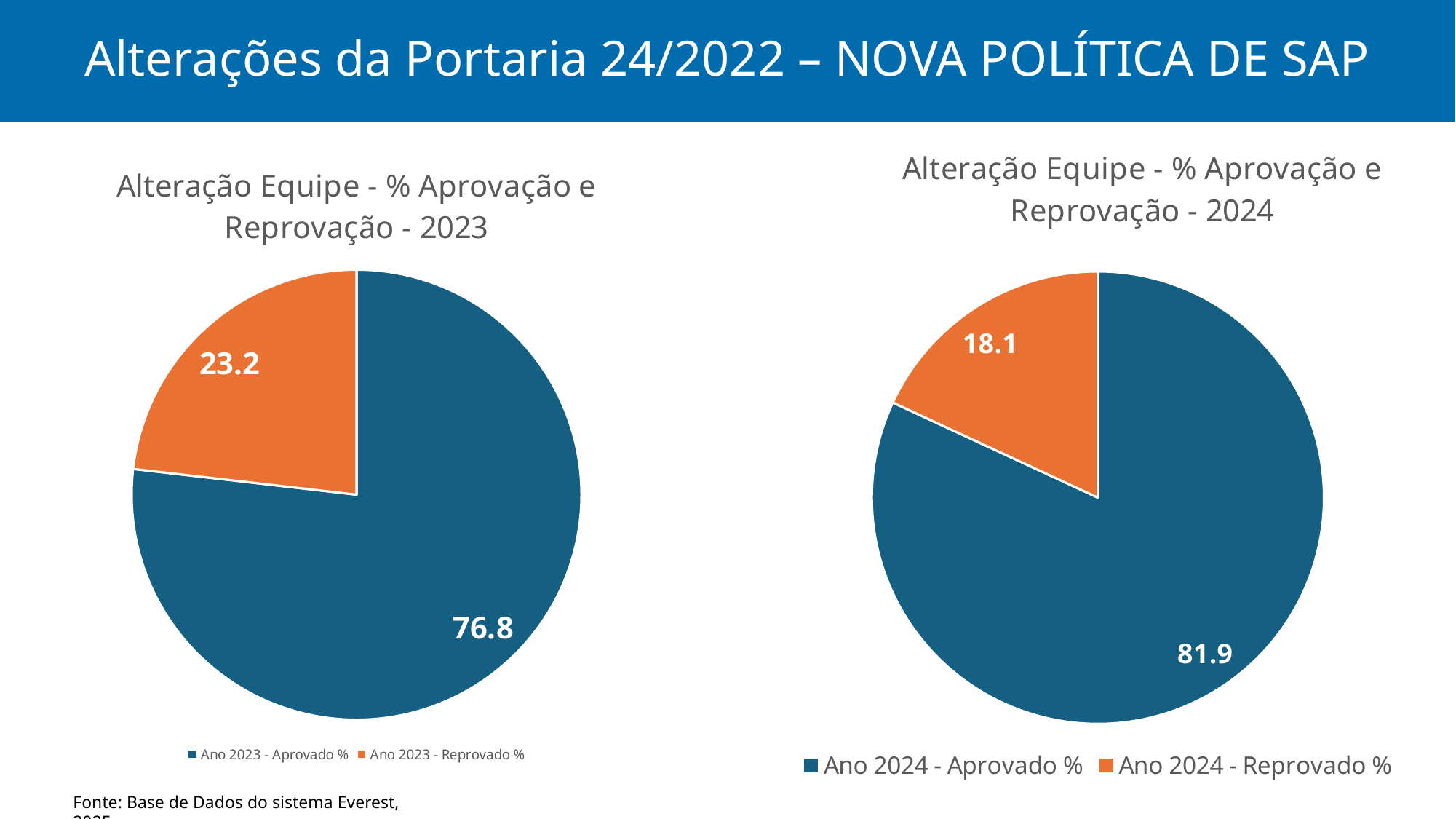
In the 2024 chart (right), what is the difference between the Aprovado and Reprovado values? 63.8 In the 2023 chart (left), which slice is the largest? Ano 2023 - Aprovado % How many series does the legend of the 2023 chart (left) list? 2 Which is larger: the Reprovado value in the 2023 chart or the Reprovado value in the 2024 chart? 2023 (23.2) In the 2024 chart (right), what is the value for Ano 2024 - Reprovado %? 18.1 In the 2024 chart (right), which slice is the smallest? Ano 2024 - Reprovado % What kind of chart is the 2024 chart (right)? Pie chart In the 2024 chart (right), what is the value for Ano 2024 - Aprovado %? 81.9 In the 2023 chart (left), what is the value for Ano 2023 - Reprovado %? 23.2 In the 2023 chart (left), what is the difference between the Aprovado and Reprovado values? 53.6 In the 2024 chart (right), what colour is the Ano 2024 - Reprovado % slice? Orange In the 2023 chart (left), what is the value for Ano 2023 - Aprovado %? 76.8